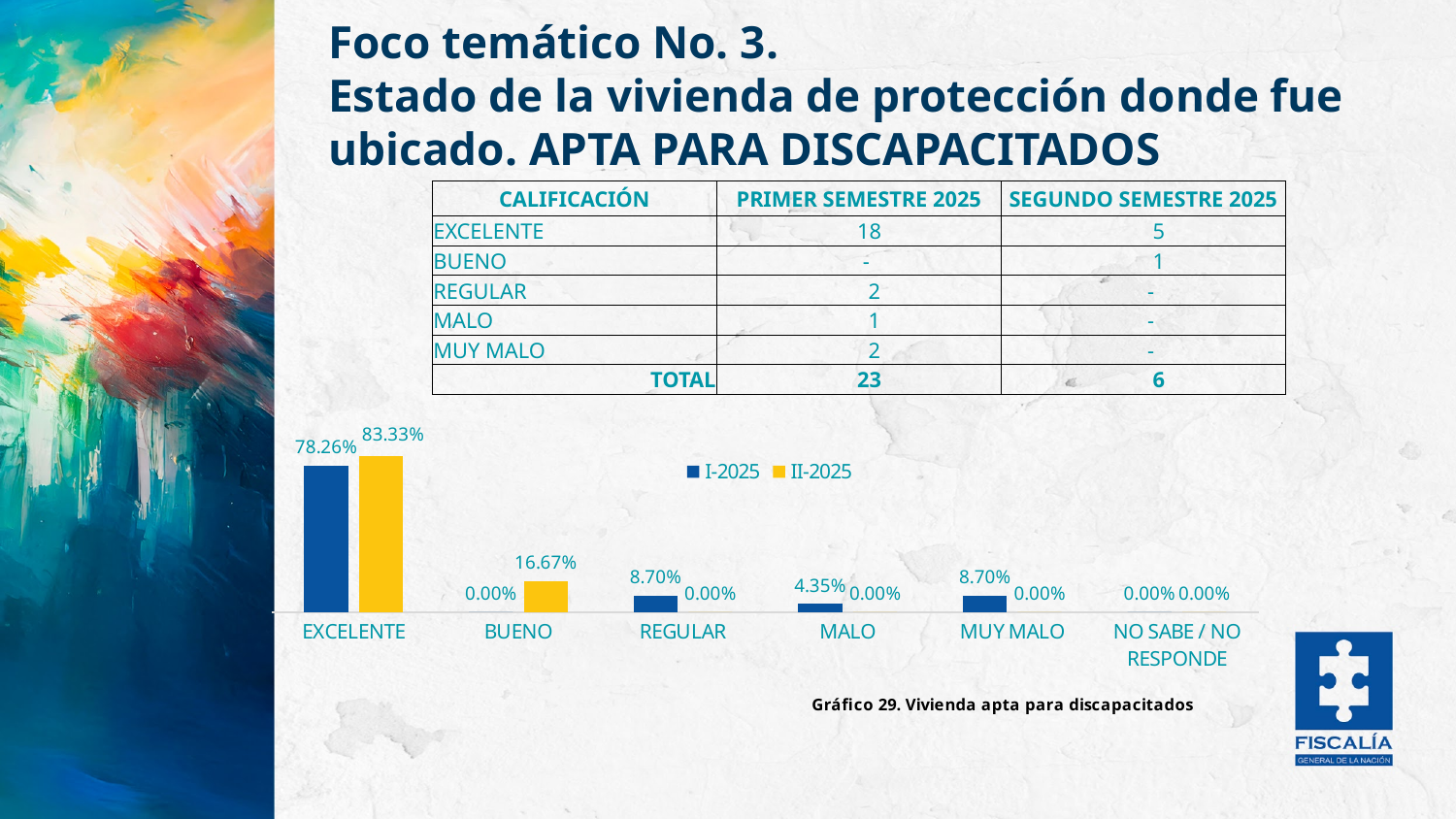
What is the value for EXCELENTE in the II-2025 series? 83.33% Which is larger for REGULAR: the I-2025 value or the II-2025 value? I-2025 What is the value for EXCELENTE in the I-2025 series? 78.26% What are the names of the two series in the chart legend? I-2025 and II-2025 What is the difference between the II-2025 and I-2025 values for EXCELENTE? 5.07% What is the value for BUENO in the II-2025 series? 16.67% What type of chart is shown on the slide? bar chart Which category has the highest value in the I-2025 series? EXCELENTE What is the difference between the I-2025 values for REGULAR and MALO? 4.35% How many categories are shown on the x axis of the chart? 6 How many series does the chart legend list? 2 What is the value for MALO in the I-2025 series? 4.35%